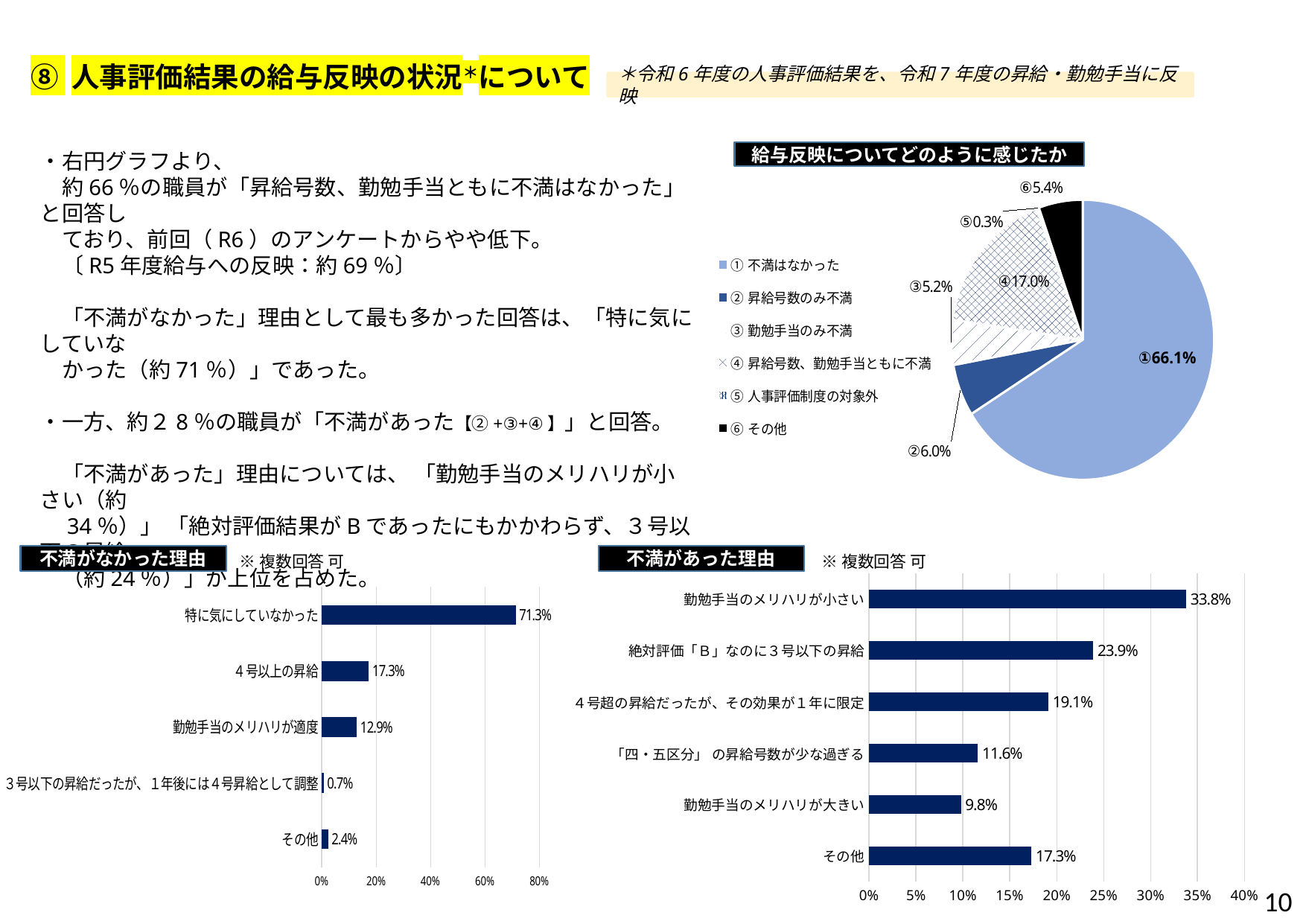
In the pie chart 「給与反映についてどのように感じたか」, which category has the smallest share? ⑤ 人事評価制度の対象外 In the bar chart 「不満があった理由」, how many categories are shown? 6 In the bar chart 「不満がなかった理由」, which category has the lowest value? 3号以下の昇給だったが、1年後には4号昇給として調整 In the pie chart 「給与反映についてどのように感じたか」, which is larger: ② 昇給号数のみ不満 or ③ 勤勉手当のみ不満? ② 昇給号数のみ不満 In the bar chart 「不満がなかった理由」, what is the value for 特に気にしていなかった? 71.3% In the pie chart 「給与反映についてどのように感じたか」, how many slices are there? 6 In the pie chart 「給与反映についてどのように感じたか」, what is the value for ④ 昇給号数、勤勉手当ともに不満? 17.0% In the bar chart 「不満があった理由」, what is the value for 勤勉手当のメリハリが大きい? 9.8% In the bar chart 「不満がなかった理由」, what is the difference between 4号以上の昇給 and 勤勉手当のメリハリが適度? 4.4% In the bar chart 「不満があった理由」, which category has the highest value? 勤勉手当のメリハリが小さい What type of chart is 「不満があった理由」? Bar chart In the pie chart 「給与反映についてどのように感じたか」, what share is shown for ① 不満はなかった? 66.1%